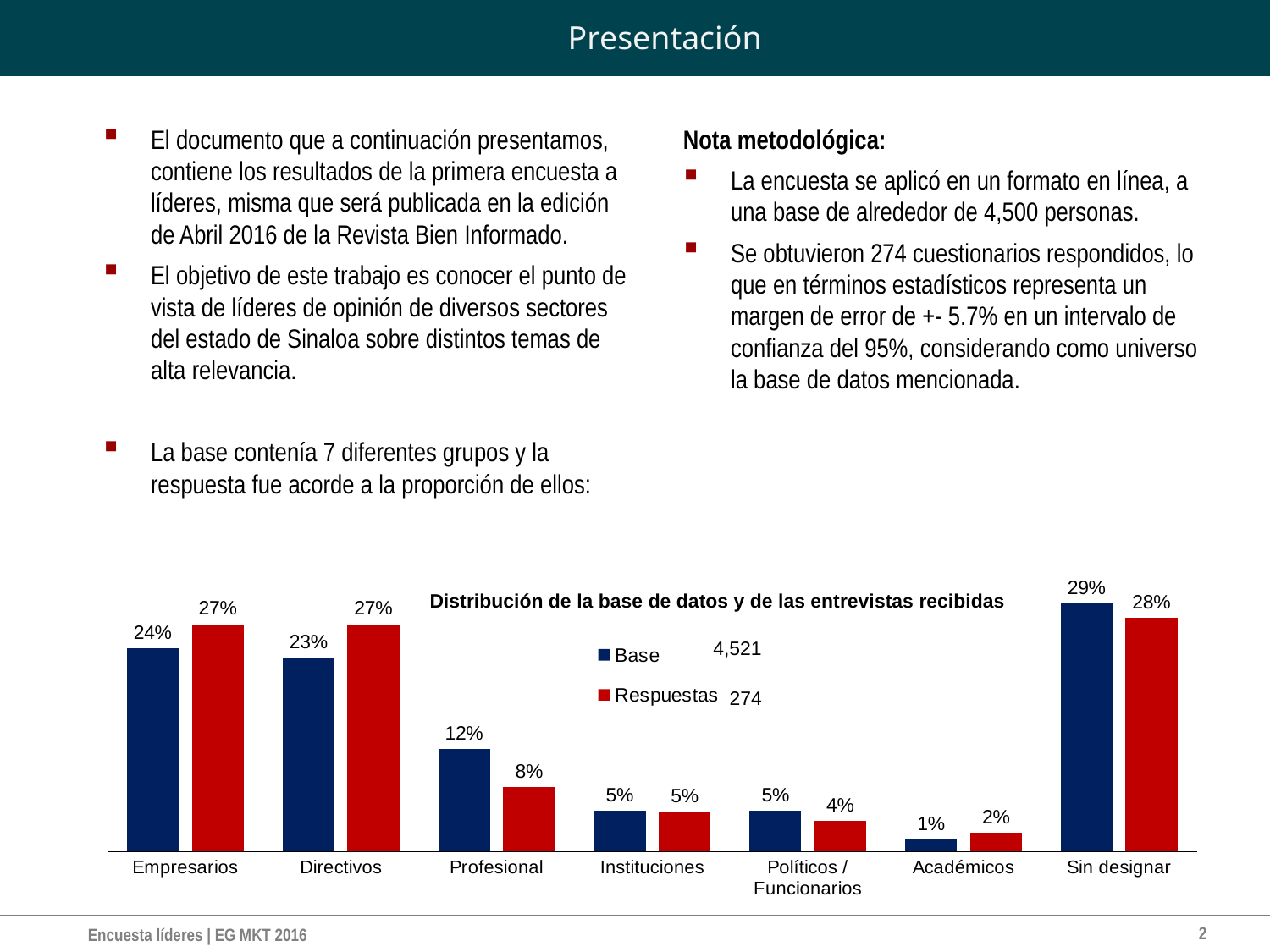
What is the difference between the Base and Respuestas values for Profesional? 4% For Empresarios, which is larger: the Base value or the Respuestas value? Respuestas What is the Respuestas value for Profesional? 8% What type of chart is shown on the slide? bar chart How many categories are shown on the x axis? 7 How many series does the legend list? 2 What is the title of the chart? Distribución de la base de datos y de las entrevistas recibidas Which category has the highest Base value? Sin designar What is the Base value for Académicos? 1% What is the Respuestas value for Directivos? 27% Which category has the lowest Respuestas value? Académicos What is the Base value for Empresarios? 24%